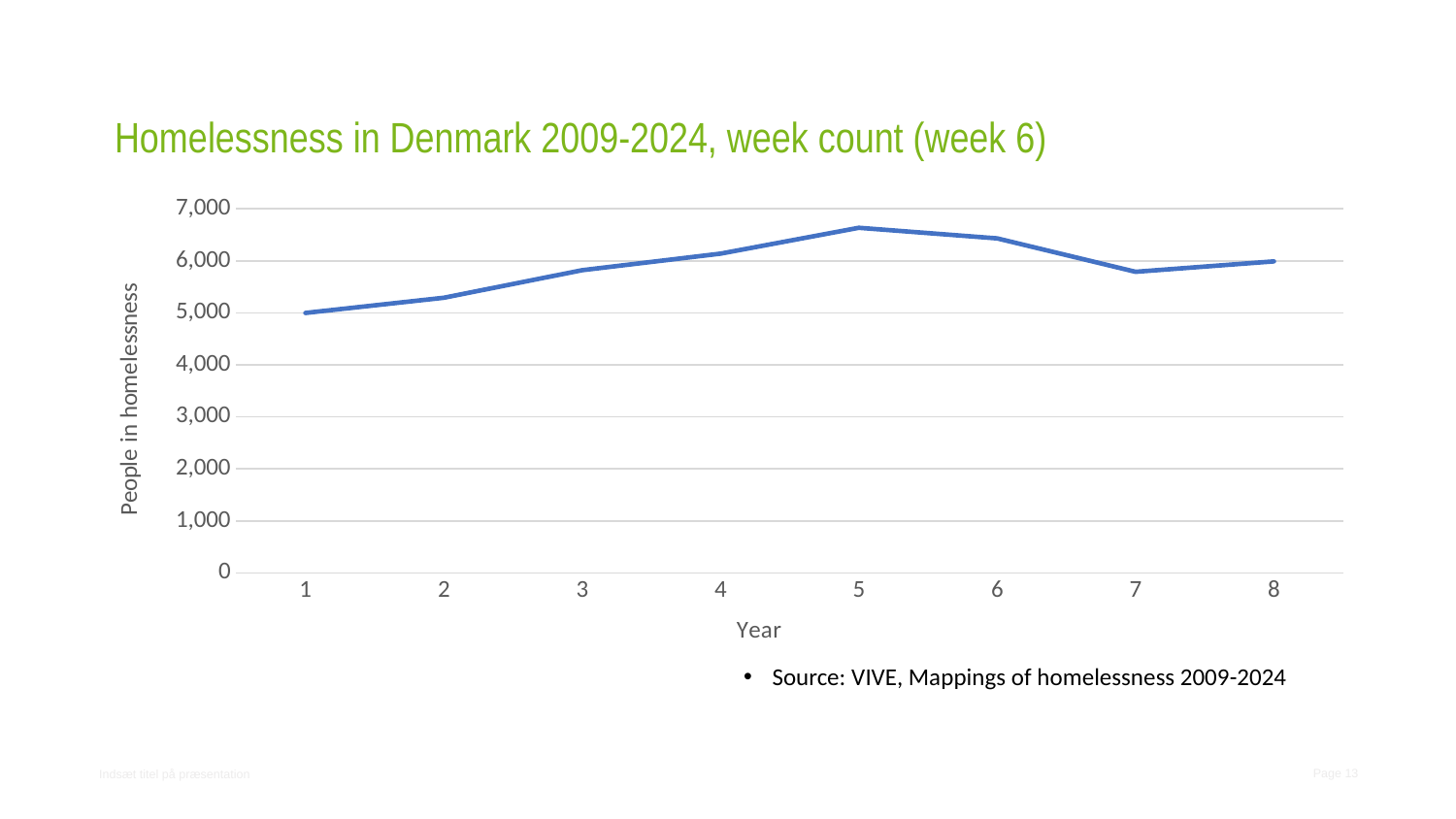
Does the line rise or fall from point 1 to point 5? rise How many points are plotted along the x axis? 8 At which x-axis point is the number of people in homelessness highest? 5 Which has the larger value, point 5 or point 6? 5 What kind of chart is shown on the slide? line chart Is the value at point 6 greater or less than 6,000? greater Is the value at point 2 greater or less than 5,000? greater Which has the larger value, point 3 or point 4? 4 What is the title of the vertical axis? People in homelessness Is the value at point 5 greater or less than 6,000? greater At which x-axis point is the number of people in homelessness lowest? 1